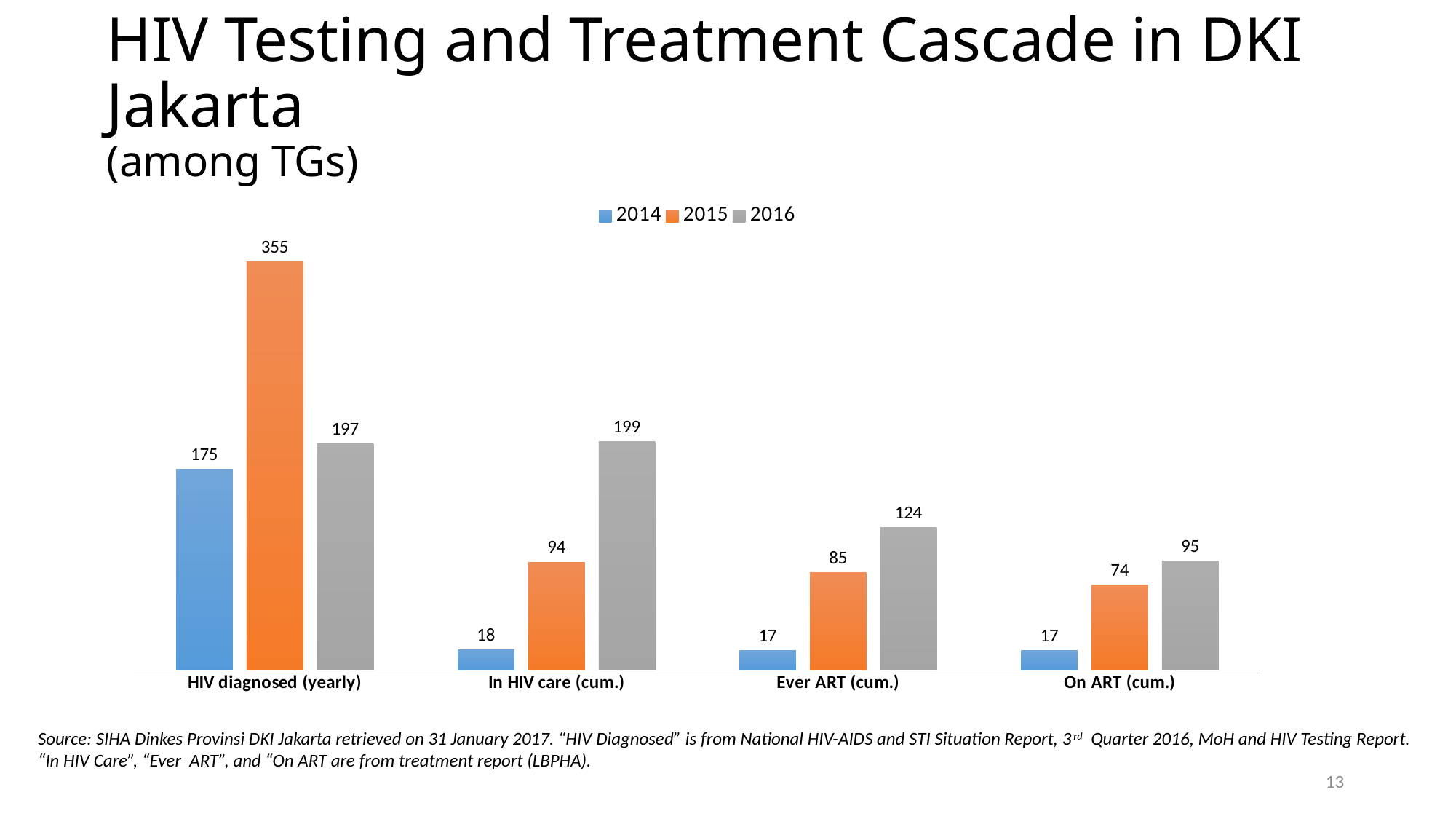
What is the 2016 value for Ever ART (cum.)? 124 What is the 2015 value for HIV diagnosed (yearly)? 355 Which colour represents the 2016 series in the legend? Grey How many categories are shown on the x axis? 4 Which is larger for In HIV care (cum.): the 2015 value or the 2016 value? 2016 What is the 2016 value for In HIV care (cum.)? 199 What kind of chart is shown on the slide? Bar chart What is the difference between the 2015 and 2014 values for HIV diagnosed (yearly)? 180 Which category has the lowest 2016 value? On ART (cum.) What is the 2014 value for On ART (cum.)? 17 How many series does the legend list? 3 Which category has the highest 2015 value? HIV diagnosed (yearly)